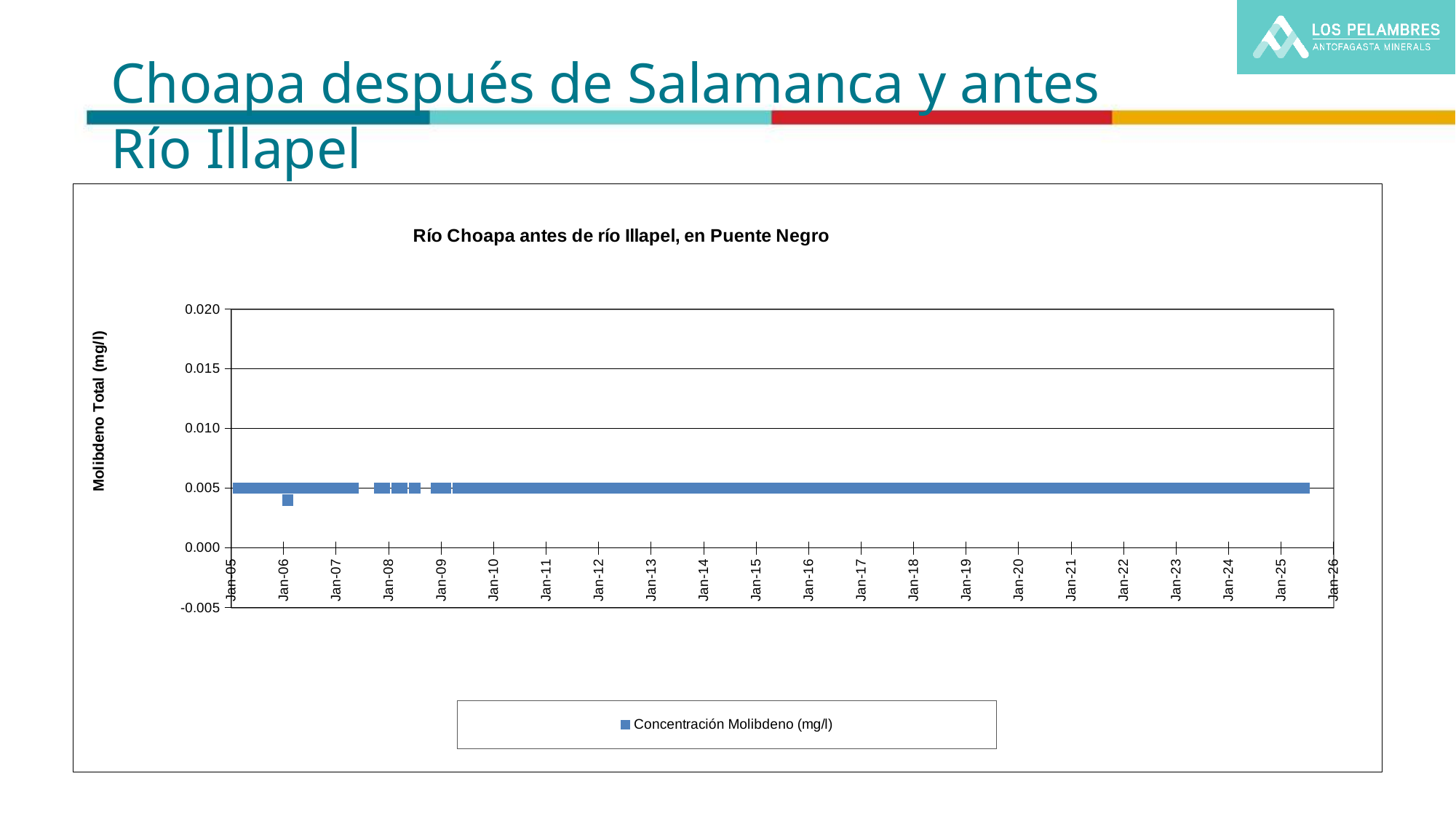
What is the name of the series shown in the legend? Concentración Molibdeno (mg/l) How many series does the legend list? 1 Is the value plotted at Jan-15 greater or less than 0.010? less At what value on the y axis do most of the plotted points lie? 0.005 Is the value plotted at Jan-20 greater or less than 0.010? less Do the plotted values rise, fall, or stay roughly flat from Jan-07 to Jan-25? Stay roughly flat Is the lowest plotted point, near Jan-06, greater or less than 0.005? less What kind of chart is shown on the slide? Line chart What is the title of the chart? Río Choapa antes de río Illapel, en Puente Negro Around which year does the lowest plotted point occur? Jan-06 What is the highest value plotted on the chart? 0.005